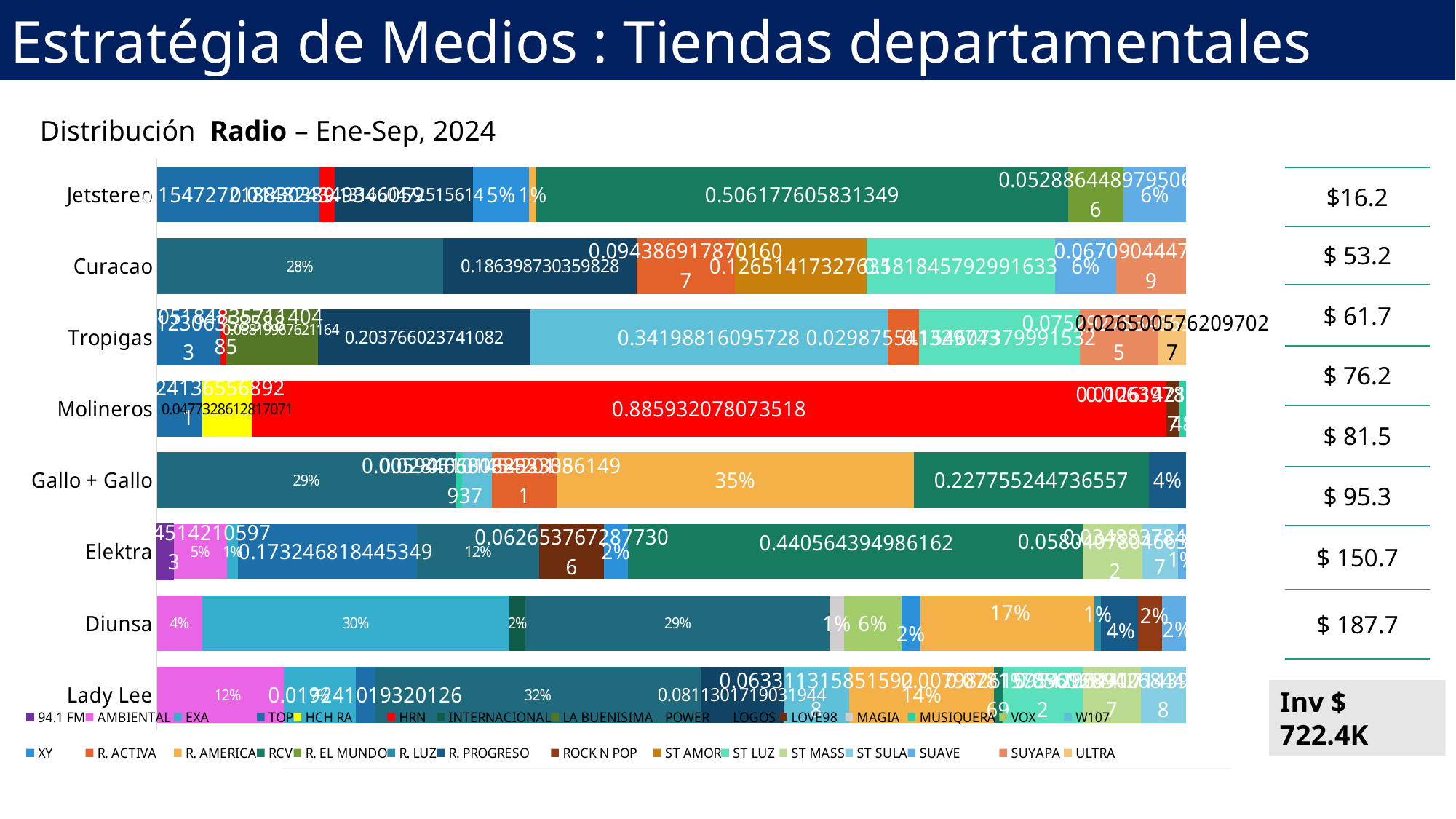
What kind of chart is shown on the slide? bar chart What value is printed on the large dark green segment of the Jetstereo bar? 0.506177605831349 How many retailers (categories) are plotted on the y axis of the chart? 8 In the Lady Lee bar, what is the difference between the segment labelled 32% and the segment labelled 12%? 20% What value is printed on the dark green segment of the Elektra bar? 0.440564394986162 What total investment figure is shown in the box at the bottom right of the chart? Inv $ 722.4K What value is printed on the large red segment of the Molineros bar? 0.885932078073518 What period does the chart subtitle say the radio distribution covers? Ene-Sep, 2024 In the Diunsa bar, which is larger: the segment labelled 30% or the segment labelled 17%? 30% What percentage is printed on the orange segment of the Gallo + Gallo bar? 35% What is the largest percentage printed in the Diunsa bar? 30% What percentage is printed on the teal segment of the Lady Lee bar? 32%